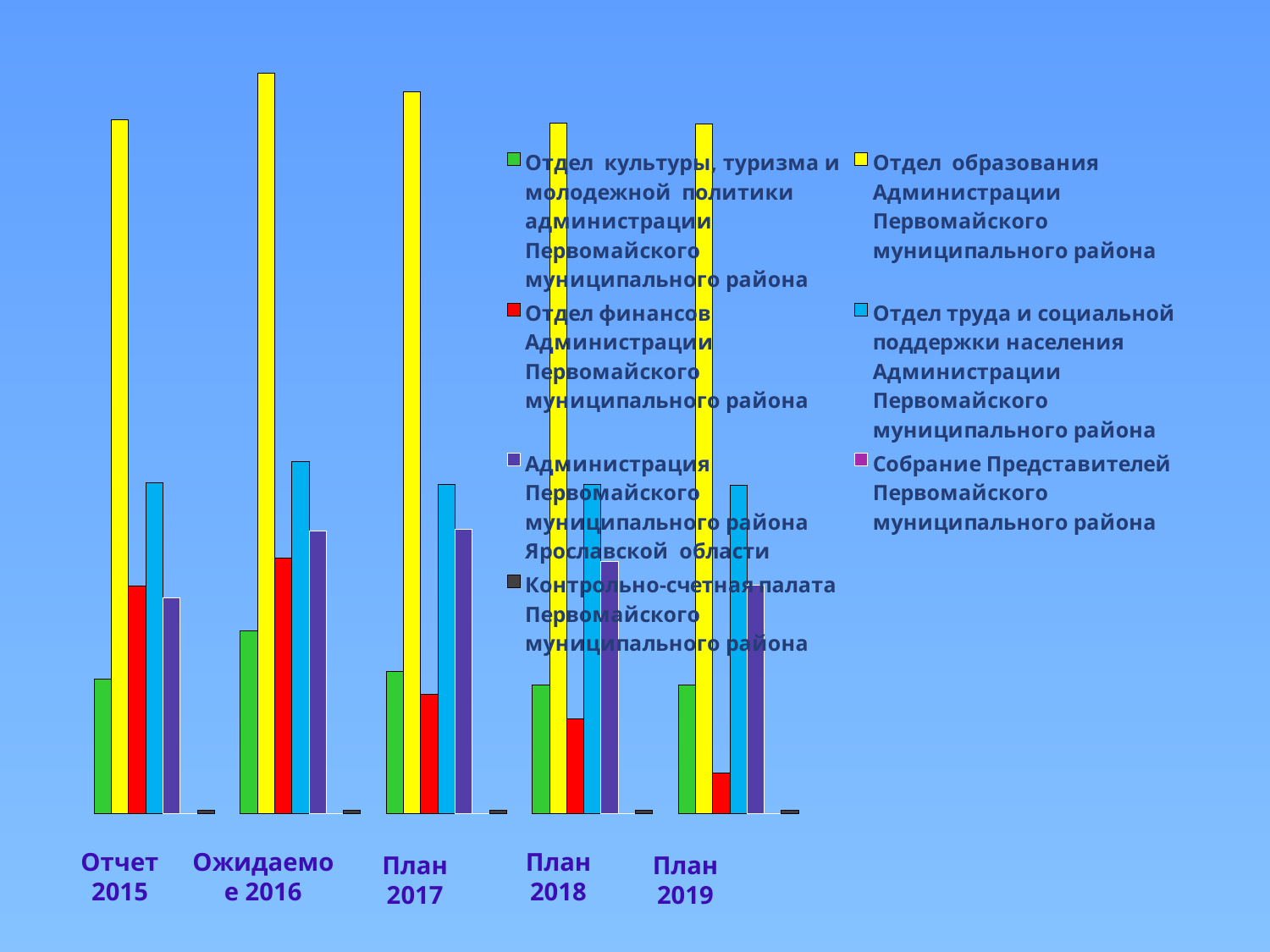
What colour represents Отдел финансов Администрации Первомайского муниципального района in the legend? red What colour represents Отдел образования Администрации Первомайского муниципального района in the legend? yellow How many series does the legend list? 7 In the План 2019 category, which is larger: the bar for Отдел труда и социальной поддержки населения or the bar for Отдел финансов? Отдел труда и социальной поддержки населения How many categories are shown along the x axis? 5 Is the bar for Отдел образования larger in Ожидаемое 2016 or in План 2017? Ожидаемое 2016 In which category is the bar for Отдел образования Администрации Первомайского муниципального района the tallest? Ожидаемое 2016 In which category is the bar for Отдел финансов Администрации Первомайского муниципального района the lowest? План 2019 What kind of chart is shown on the slide? bar chart Which series has the tallest bar in the Отчет 2015 category? Отдел образования Администрации Первомайского муниципального района In the Отчет 2015 category, which is larger: the bar for Отдел финансов or the bar for Отдел культуры, туризма и молодежной политики? Отдел финансов Does the bar for Отдел финансов rise or fall from Ожидаемое 2016 to План 2019? fall